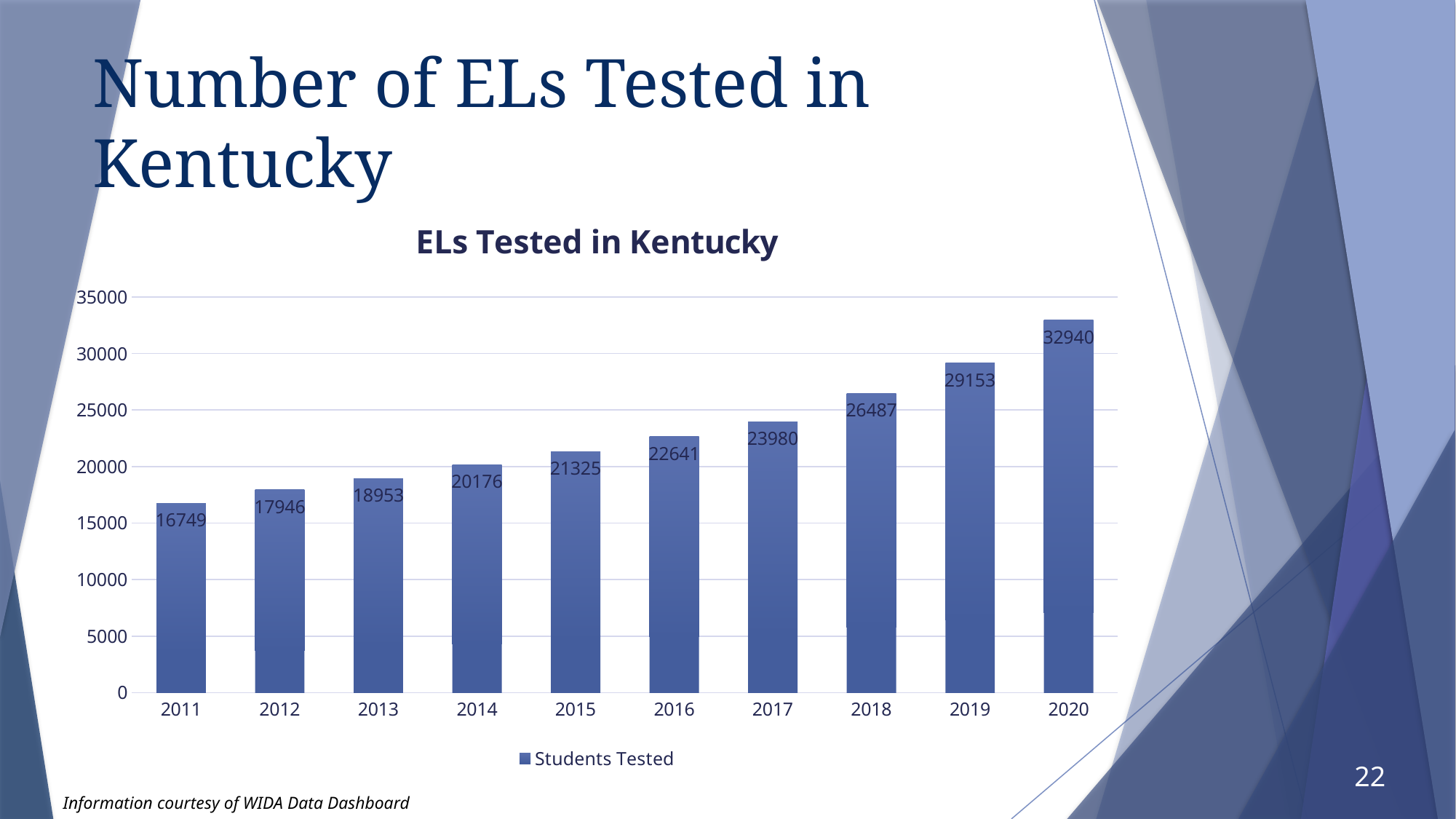
How many years are shown on the x axis? 10 Which is larger, the value for 2014 or the value for 2017? 2017 Do the values rise or fall from 2011 to 2020? rise Which year has the highest number of students tested? 2020 What is the value for 2011? 16749 What kind of chart is this? bar chart Which year has the lowest number of students tested? 2011 What is the value for 2016? 22641 What is the difference between the values for 2012 and 2011? 1197 What is the value for 2020? 32940 What is the difference between the values for 2020 and 2019? 3787 Is the value for 2018 greater or less than 25000? greater